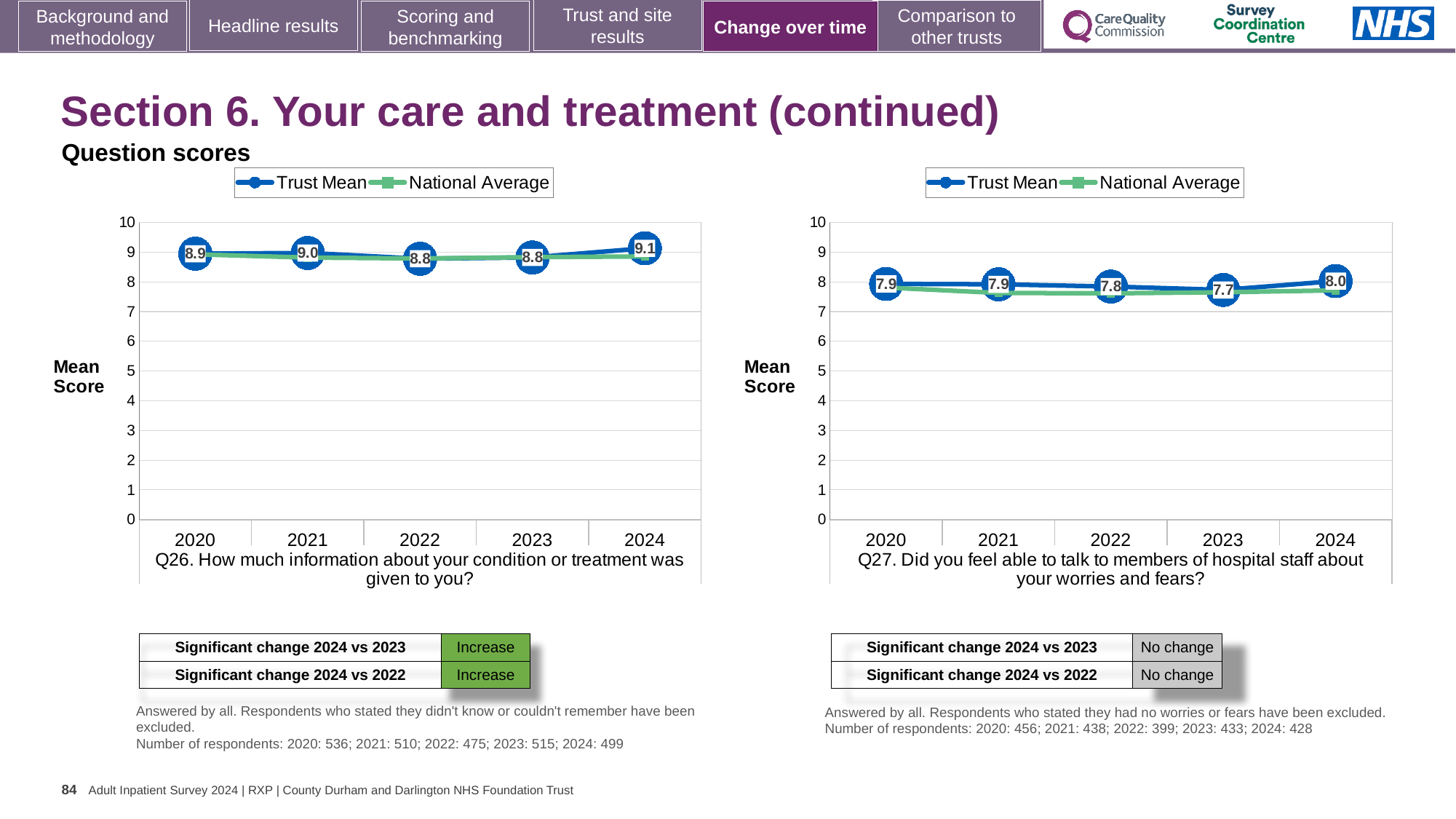
In the Q27 chart (right), what is the Trust Mean score for 2024? 8.0 In the Q26 chart (left), what is the Trust Mean score for 2024? 9.1 In the Q27 chart (right), what is the Trust Mean score for 2023? 7.7 In the Q26 chart (left), which year has the highest Trust Mean score? 2024 In the Q26 chart (left), is the National Average value for 2024 greater or less than 8? greater In the Q26 chart (left), what is the difference between the Trust Mean scores for 2024 and 2023? 0.3 In the Q27 chart (right), is the Trust Mean score for 2021 larger or smaller than the score for 2023? larger How many years are plotted on the x axis of the Q27 chart (right)? 5 How many series does the legend of the Q26 chart (left) list? 2 In the Q27 chart (right), which year has the lowest Trust Mean score? 2023 In the Q27 chart (right), what is the difference between the Trust Mean scores for 2024 and 2023? 0.3 In the Q26 chart (left), what is the Trust Mean score for 2020? 8.9